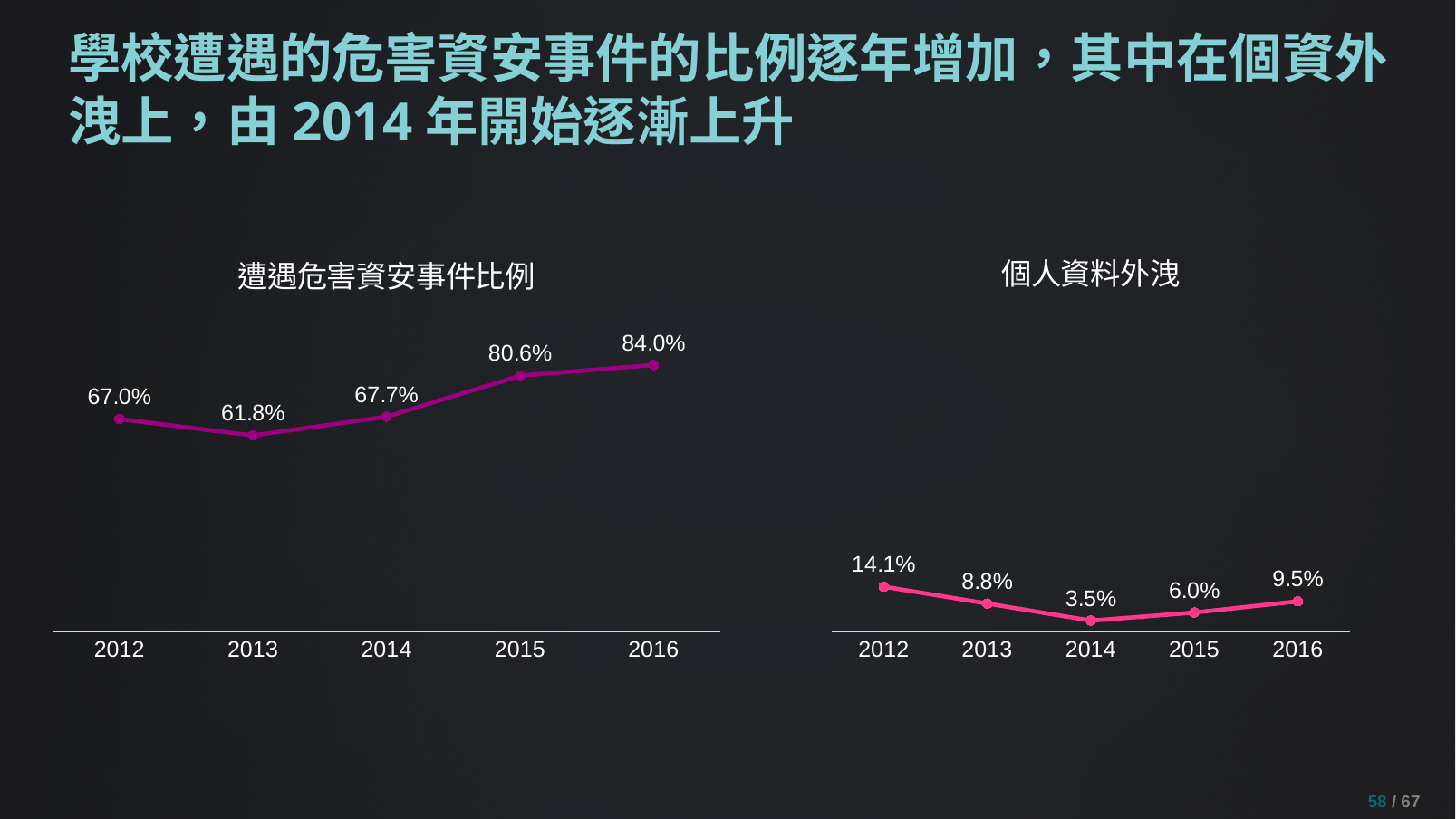
In the right chart titled 個人資料外洩, which year has the lowest value? 2014 In the left chart titled 遭遇危害資安事件比例, what is the value for 2016? 84.0% What type of chart is the right chart titled 個人資料外洩? line chart In the right chart titled 個人資料外洩, what is the difference between the 2012 and 2013 values? 5.3% In the left chart titled 遭遇危害資安事件比例, which year has the lowest value? 2013 In the left chart titled 遭遇危害資安事件比例, what is the difference between the 2016 and 2012 values? 17.0% In the right chart titled 個人資料外洩, which is larger, the value for 2013 or the value for 2015? 2013 In the right chart titled 個人資料外洩, which year has the highest value? 2012 What is the title of the left chart? 遭遇危害資安事件比例 In the right chart titled 個人資料外洩, what is the value for 2014? 3.5% In the left chart titled 遭遇危害資安事件比例, do the values rise or fall from 2013 to 2016? rise In the left chart titled 遭遇危害資安事件比例, how many data points are plotted? 5